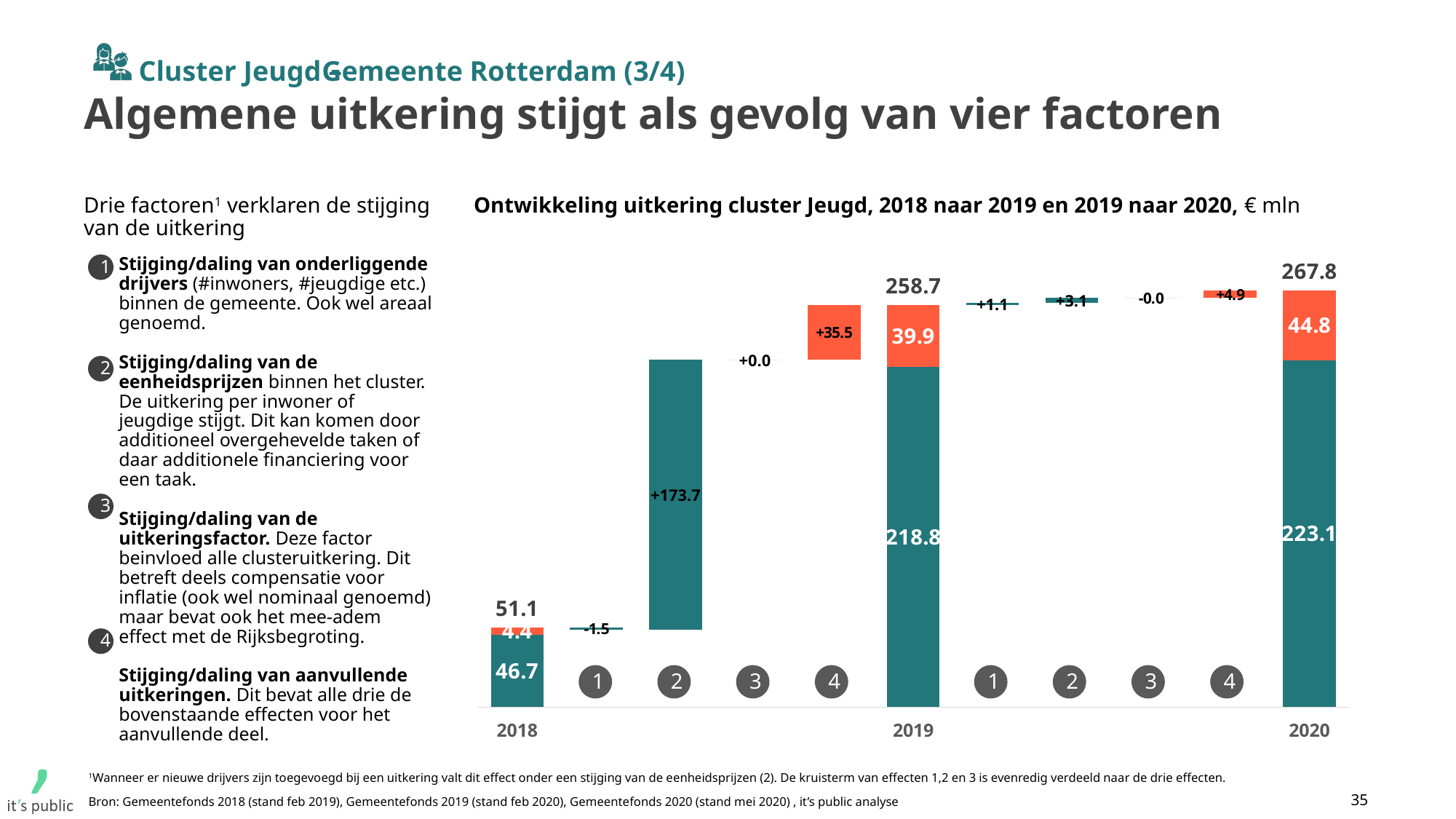
What is the value of the change labelled with factor 1 between 2018 and 2019? -1.5 What is the total uitkering for cluster Jeugd in 2020 according to the chart? 267.8 What is the total uitkering for cluster Jeugd in 2019 according to the chart? 258.7 By how much did the total uitkering increase from 2019 to 2020? 9.1 What is the orange (top) segment value of the 2020 bar? 44.8 What is the value of the change labelled with factor 4 between 2018 and 2019? +35.5 What is the value of the change labelled with factor 2 between 2018 and 2019? +173.7 In which unit are the values in the chart expressed, according to the chart title? € mln What is the teal (bottom) segment value of the 2019 bar? 218.8 What is the value of the change labelled with factor 4 between 2019 and 2020? +4.9 What is the total uitkering for cluster Jeugd in 2018 according to the chart? 51.1 Which of the four factors contributes the largest change between 2018 and 2019? 2